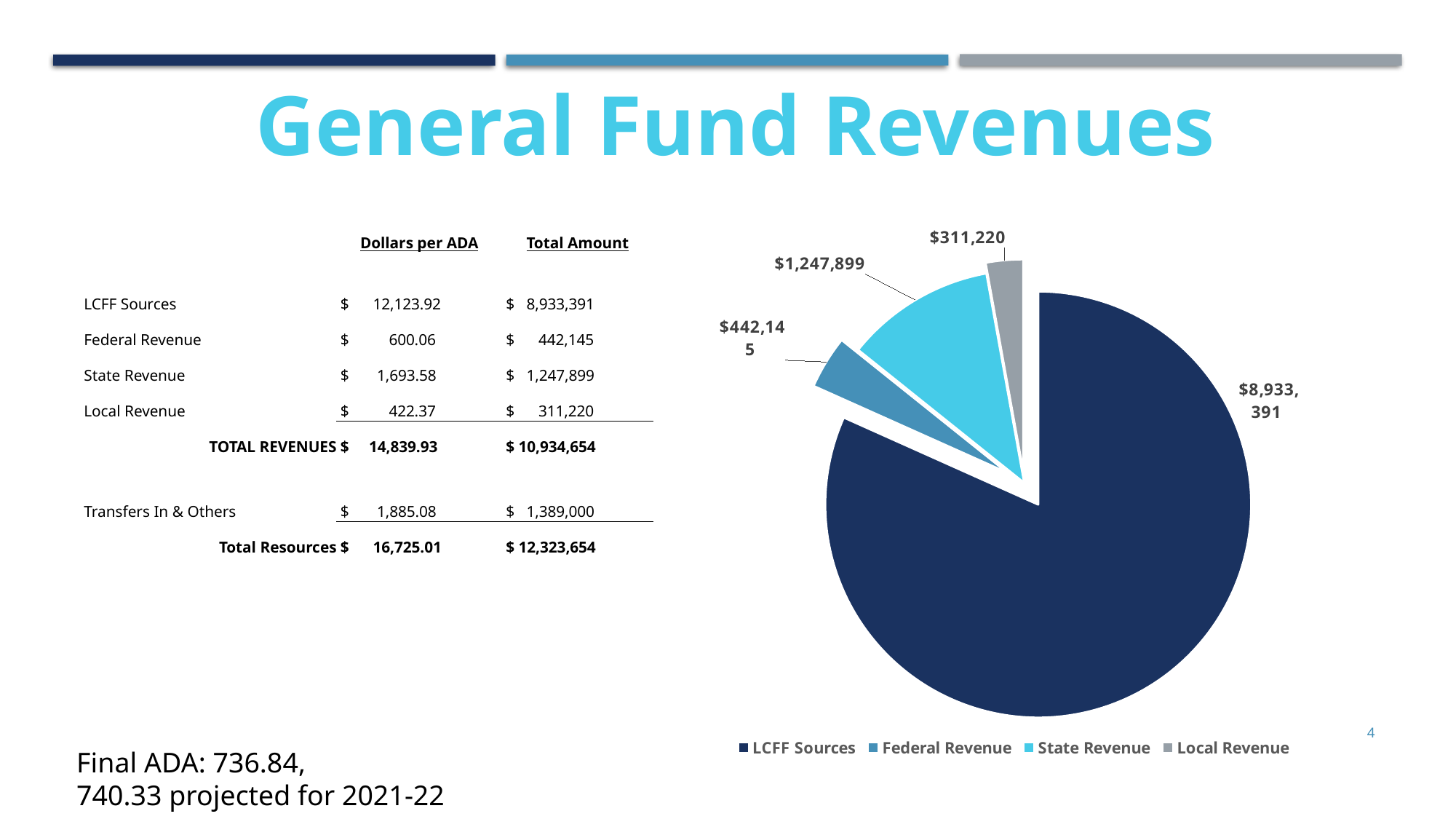
Which category has the smallest slice in the pie chart? Local Revenue Which is larger in the pie chart, Federal Revenue or State Revenue? State Revenue What is the difference between the LCFF Sources value and the State Revenue value in the pie chart? $7,685,492 Which category has the largest slice in the pie chart? LCFF Sources How many slices does the pie chart have? 4 What is the value shown for Federal Revenue in the pie chart? $442,145 How many entries does the pie chart's legend list? 4 What is the value shown for Local Revenue in the pie chart? $311,220 What is the value shown for State Revenue in the pie chart? $1,247,899 What is the value shown for LCFF Sources in the pie chart? $8,933,391 What type of chart is shown on the slide? Pie chart Which legend entry in the pie chart is shown in grey? Local Revenue